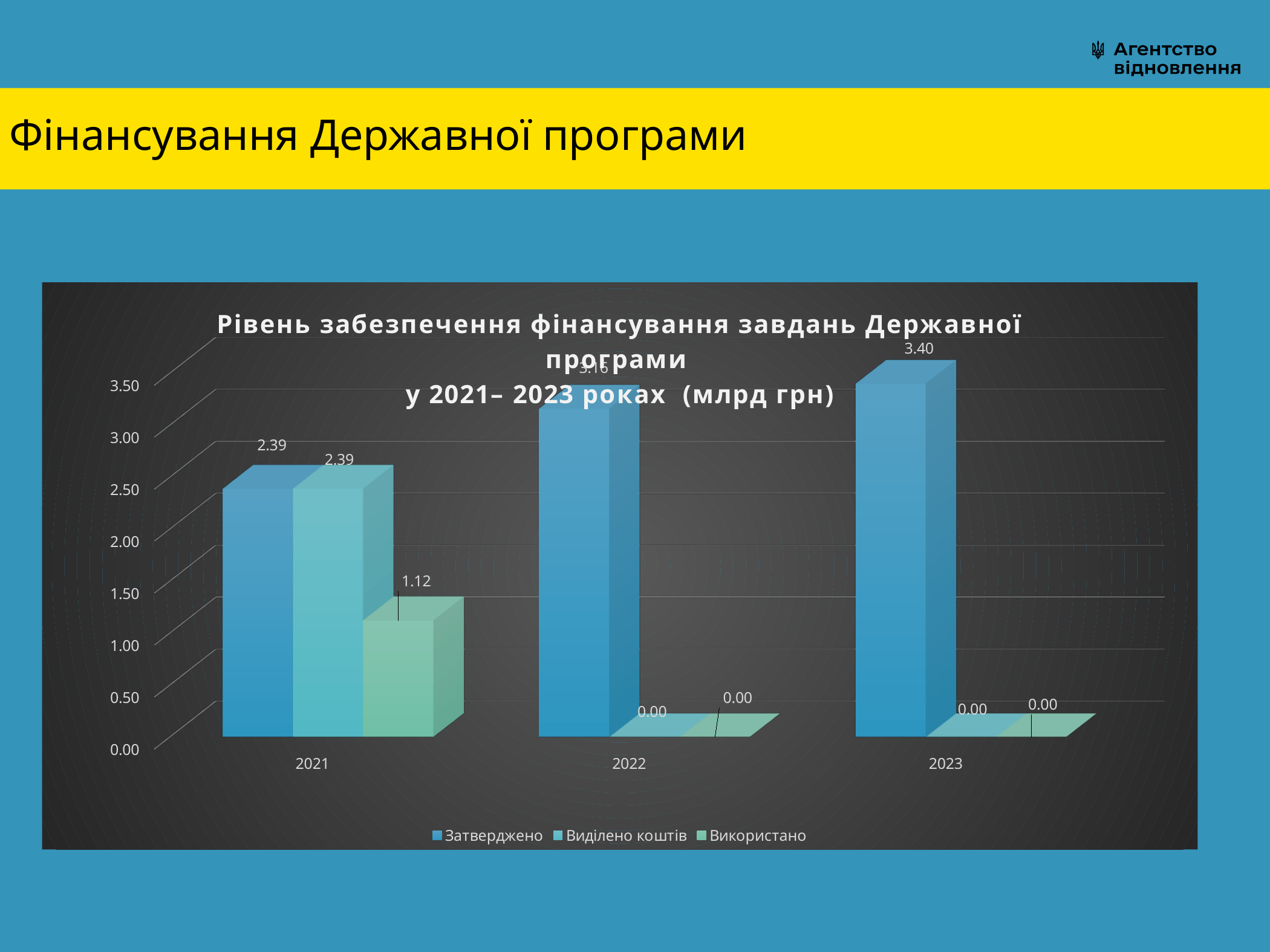
How many series does the legend list? 3 What is the value of Використано for 2021? 1.12 What is the value of Затверджено for 2023? 3.40 In which year is the Затверджено value the highest? 2023 What is the value of Виділено коштів for 2022? 0.00 What is the value of Затверджено for 2021? 2.39 What kind of chart is shown on the slide? bar chart How many years are shown on the x axis? 3 Does the Затверджено value rise or fall from 2021 to 2023? rise Is the Затверджено value for 2022 greater or less than 3.00? greater What is the difference between Затверджено and Використано in 2021? 1.27 Which year has the larger Затверджено value, 2021 or 2023? 2023